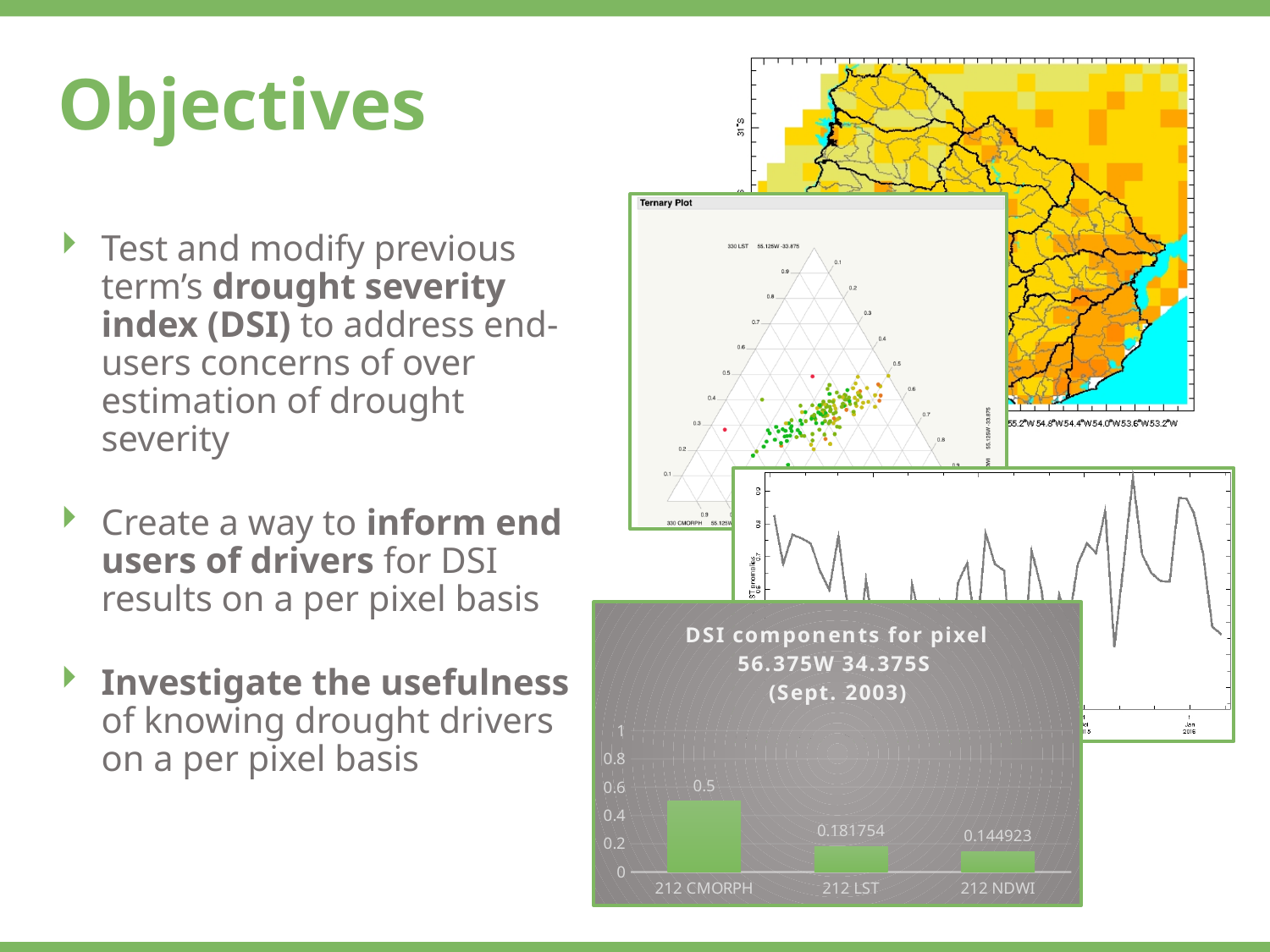
In the 'DSI components for pixel 56.375W 34.375S (Sept. 2003)' bar chart, what is the value for 212 LST? 0.181754 In the 'DSI components for pixel 56.375W 34.375S (Sept. 2003)' bar chart, what is the difference between the values for 212 LST and 212 NDWI? 0.036831 In the 'DSI components for pixel 56.375W 34.375S (Sept. 2003)' bar chart, is the value for 212 CMORPH greater or less than 0.4? greater In the 'DSI components for pixel 56.375W 34.375S (Sept. 2003)' bar chart, which category has the highest value? 212 CMORPH In the 'DSI components for pixel 56.375W 34.375S (Sept. 2003)' bar chart, what is the difference between the values for 212 CMORPH and 212 LST? 0.318246 In the 'DSI components for pixel 56.375W 34.375S (Sept. 2003)' bar chart, what is the value for 212 NDWI? 0.144923 In the 'DSI components for pixel 56.375W 34.375S (Sept. 2003)' bar chart, which category has the lowest value? 212 NDWI In the 'DSI components for pixel 56.375W 34.375S (Sept. 2003)' bar chart, what is the highest value shown on the vertical axis? 1 In the 'DSI components for pixel 56.375W 34.375S (Sept. 2003)' bar chart, how many categories are shown? 3 In the 'DSI components for pixel 56.375W 34.375S (Sept. 2003)' bar chart, which is larger, the value for 212 LST or the value for 212 NDWI? 212 LST In the 'DSI components for pixel 56.375W 34.375S (Sept. 2003)' bar chart, what is the value for 212 CMORPH? 0.5 What kind of chart is the 'DSI components for pixel 56.375W 34.375S (Sept. 2003)' chart? bar chart